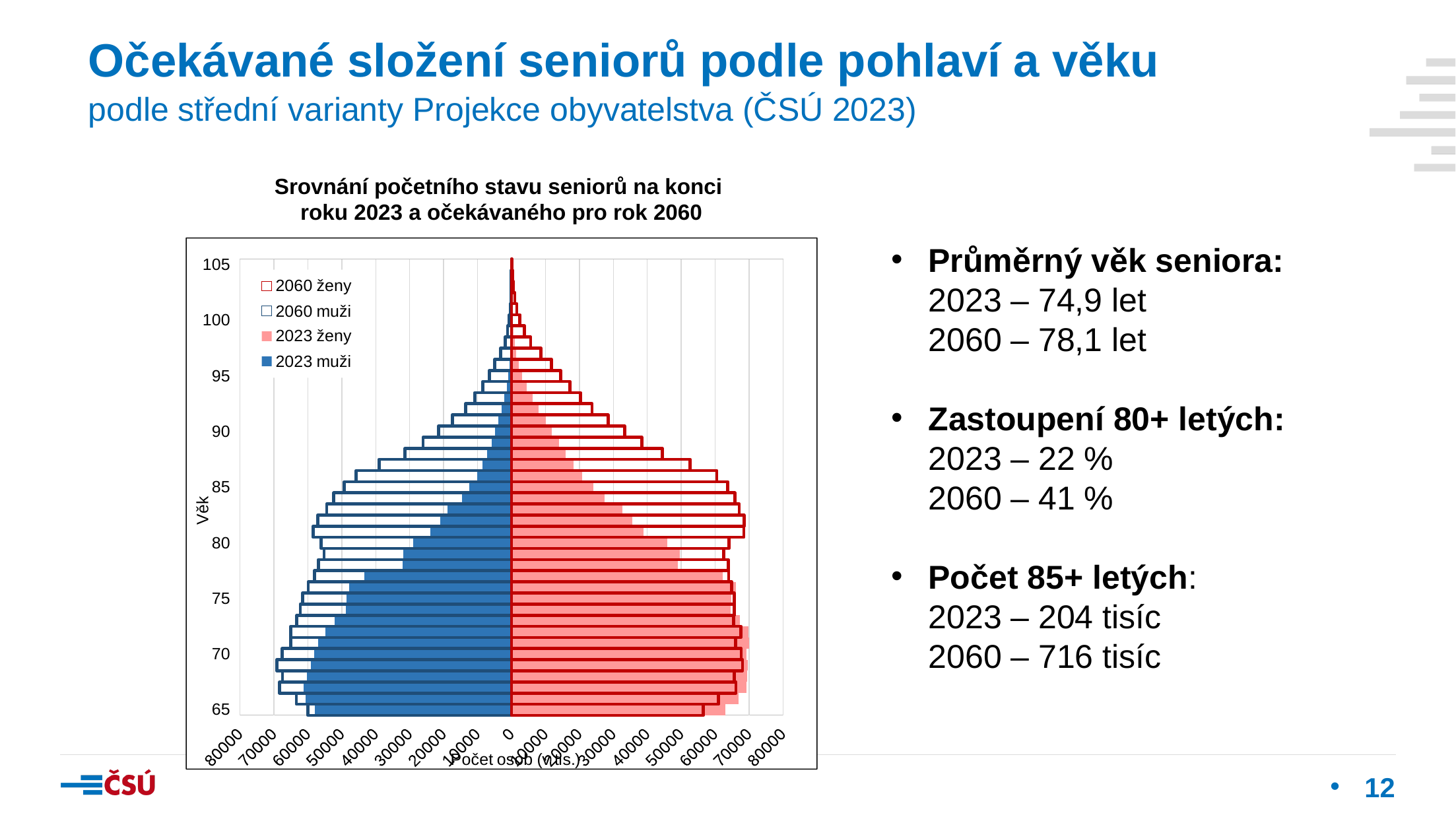
Is the value for 2023 ženy at age 70 greater or less than 60000? greater How many series does the legend of the chart list? 4 Is the value for 2060 muži at age 70 greater or less than 60000? greater What kind of chart is shown on the slide? bar chart What is the title of the chart? Srovnání početního stavu seniorů na konci roku 2023 a očekávaného pro rok 2060 Do the values for 2023 muži rise or fall as age increases from 65 to 105? fall At age 85, which is larger: the value for 2060 ženy or for 2023 ženy? 2060 ženy At age 65, which is larger: the value for 2023 ženy or for 2060 ženy? 2023 ženy Is the value for 2023 muži at age 90 greater or less than 10000? less Which series in the chart is drawn in solid blue? 2023 muži